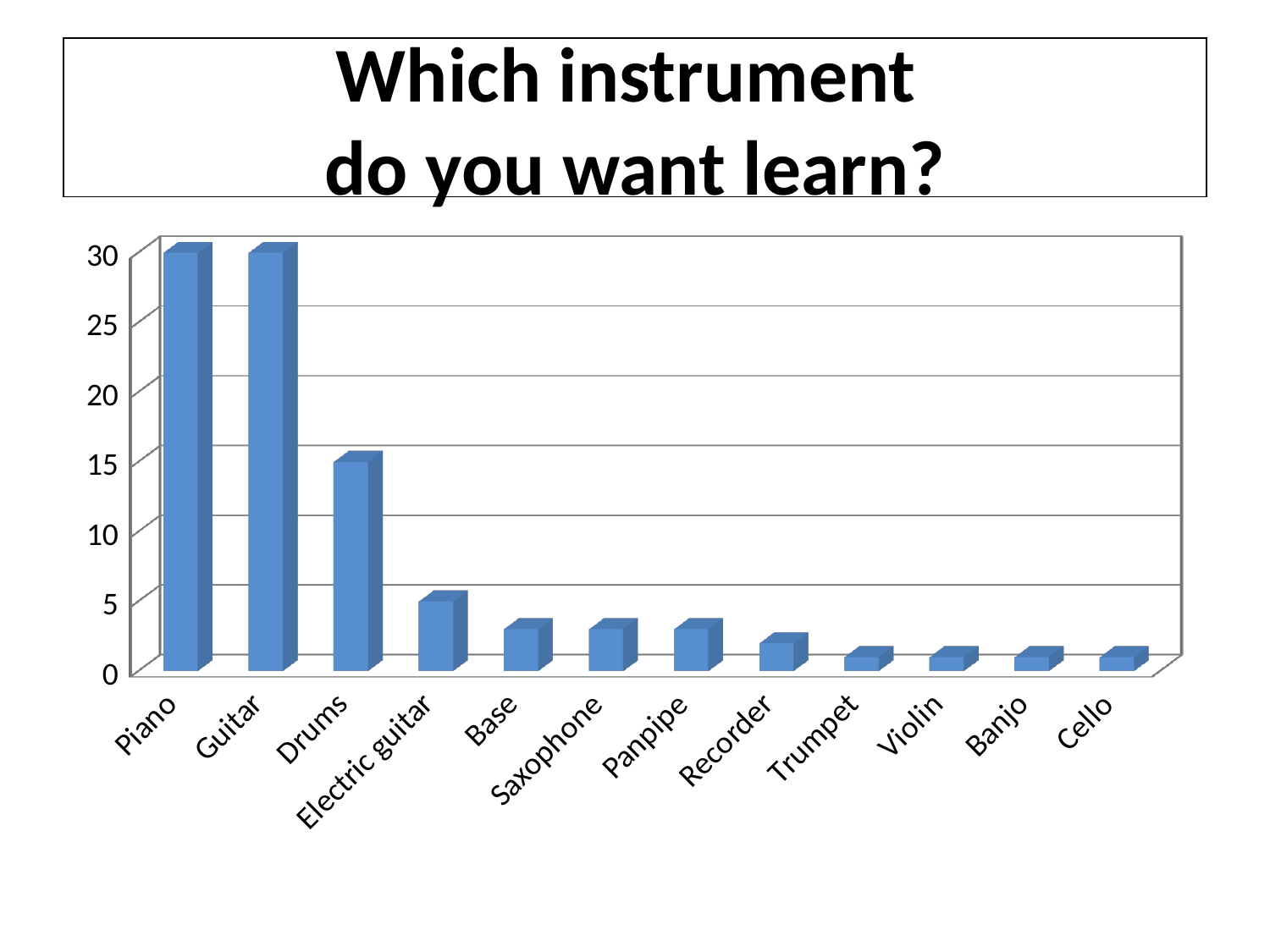
What is the title of the chart on the slide? Which instrument do you want learn? What kind of chart is shown on the slide? bar chart Which is larger, the value for Guitar or the value for Saxophone? Guitar What is the value for Drums? 15 Is the value for Trumpet greater or less than 5? less Do the values generally rise or fall moving from left to right along the x axis? fall How many instruments are shown on the x axis of the chart? 12 Which is larger, the value for Drums or the value for Electric guitar? Drums What is the value for Piano? 30 Is the value for Base greater or less than 5? less What is the difference between the values for Drums and Electric guitar? 10 What is the value for Electric guitar? 5